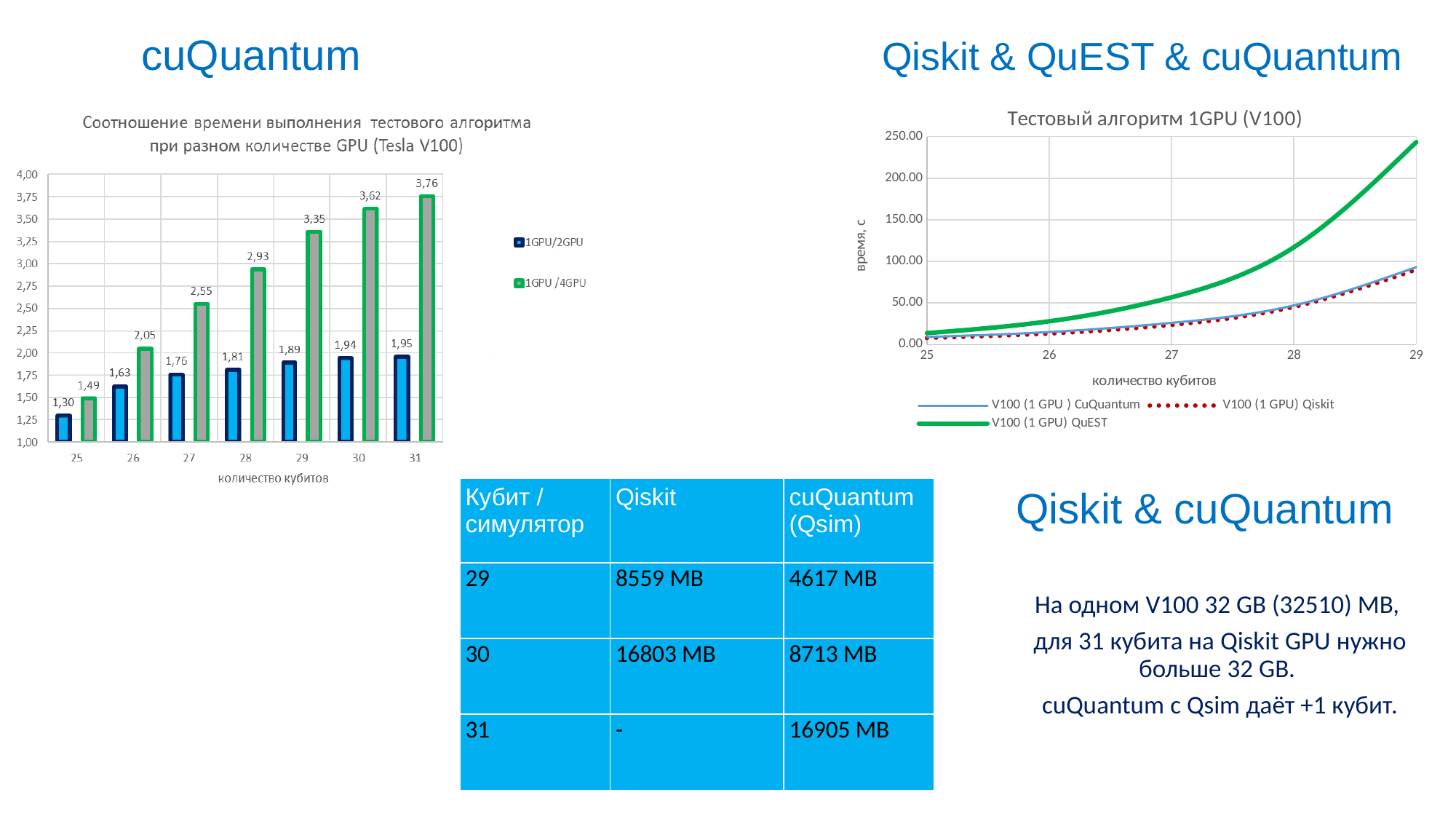
In the left bar chart, which is larger at 27 qubits: the 1GPU/2GPU value or the 1GPU /4GPU value? 1GPU /4GPU In the left bar chart (Соотношение времени выполнения тестового алгоритма), what is the value of the 1GPU /4GPU series at 31 qubits? 3,76 In the left bar chart, do the 1GPU /4GPU values rise or fall as the number of qubits increases? rise In the left bar chart, what is the difference between the 1GPU /4GPU and 1GPU/2GPU values at 30 qubits? 1,68 In the left bar chart, what is the value of the 1GPU /4GPU series at 28 qubits? 2,93 In the left bar chart, at which number of qubits is the 1GPU/2GPU value lowest? 25 How many qubit categories are shown on the x axis of the left bar chart? 7 How many series does the legend of the right chart 'Тестовый алгоритм 1GPU (V100)' list? 3 What kind of chart is the right chart titled 'Тестовый алгоритм 1GPU (V100)'? line chart In the right chart 'Тестовый алгоритм 1GPU (V100)', is the value for V100 (1 GPU) QuEST at 29 qubits greater or less than 200.00? greater In the left bar chart, at which number of qubits is the 1GPU /4GPU value highest? 31 In the left bar chart, what is the value of the 1GPU/2GPU series at 25 qubits? 1,30